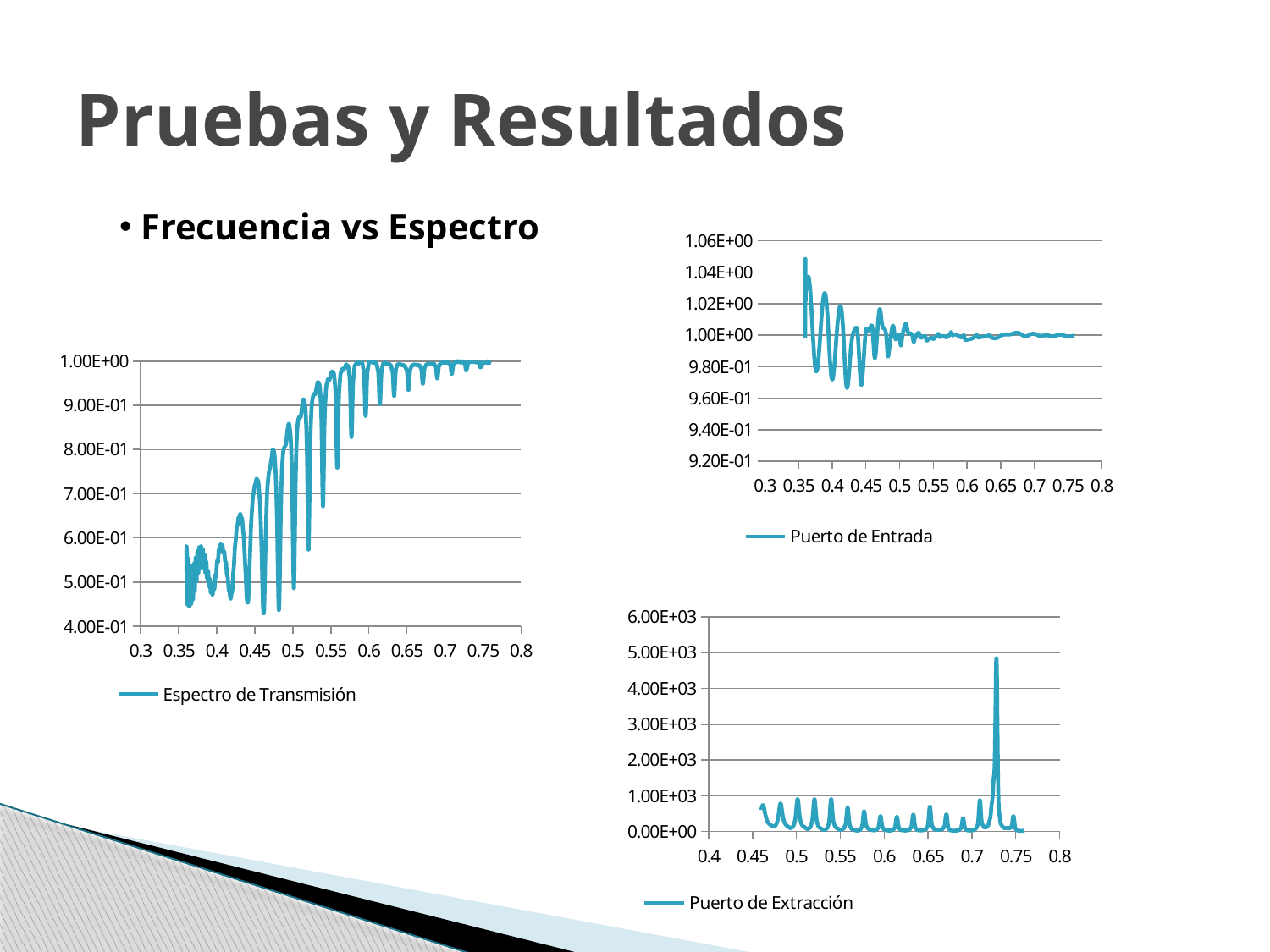
How many series does the legend of the left chart ('Espectro de Transmisión') list? 1 What type of chart is the chart at the bottom right of the slide, with the legend 'Puerto de Extracción'? line chart In the left chart ('Espectro de Transmisión'), is the value at x = 0.4 greater or less than 7.00E-01? less In the left chart ('Espectro de Transmisión'), is the value at x = 0.7 greater or less than 9.00E-01? greater What is the legend entry of the bottom-right chart on the slide? Puerto de Extracción How many series does the legend of the top-right chart ('Puerto de Entrada') list? 1 In the left chart ('Espectro de Transmisión'), do the values generally rise or fall as the x axis goes from 0.35 to 0.75? rise What is the legend entry of the top-right chart on the slide? Puerto de Entrada What type of chart is the chart on the left of the slide, with the legend 'Espectro de Transmisión'? line chart In the bottom-right chart ('Puerto de Extracción'), is the value at x = 0.6 greater or less than 1.00E+03? less